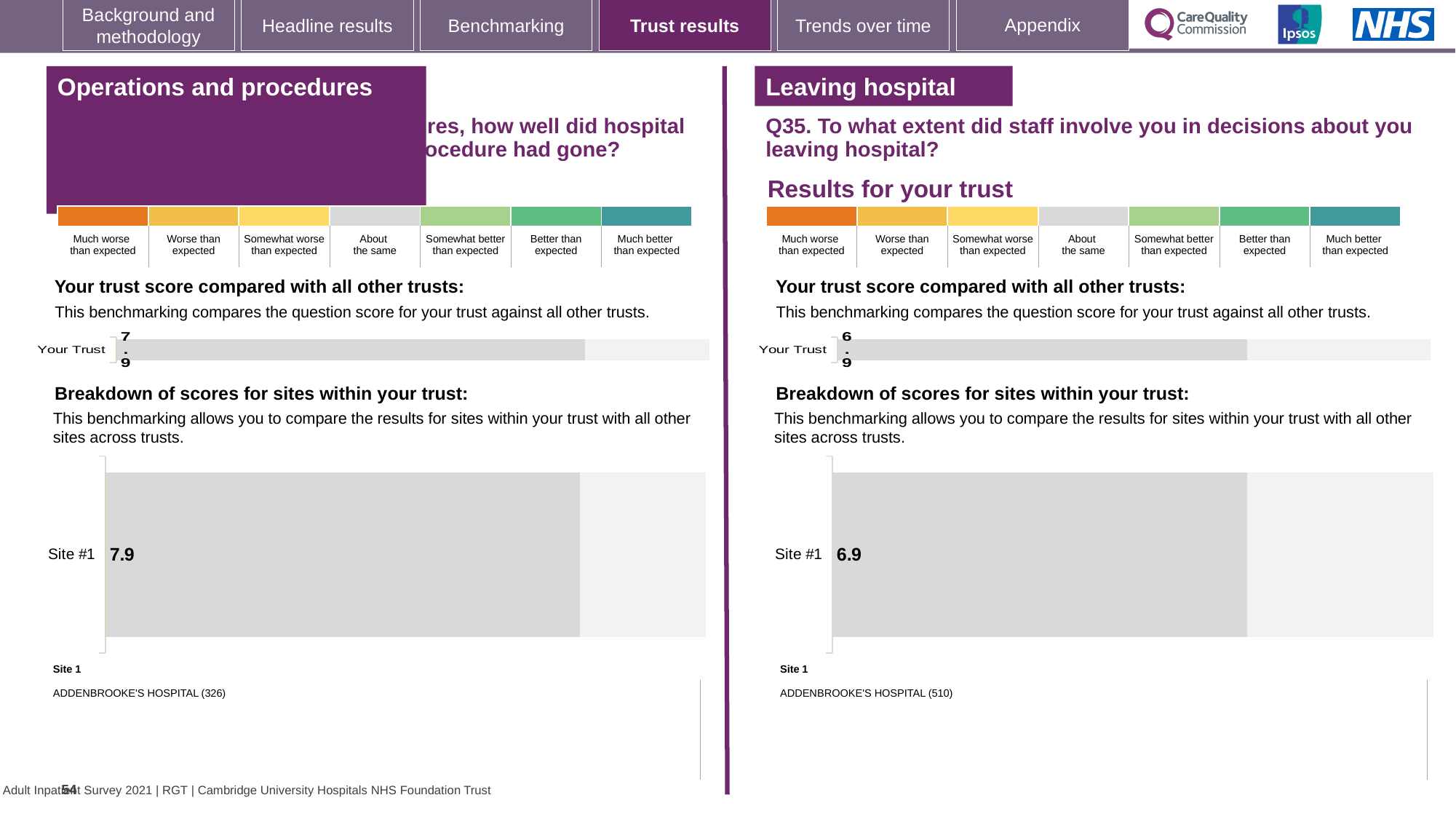
How many sites are shown in the Leaving hospital 'Breakdown of scores for sites within your trust' chart? 1 In the Operations and procedures section, what is the 'Your Trust' score shown on the trust comparison bar chart? 7.9 Is the Site #1 score in the Leaving hospital breakdown chart greater or less than 7? less In the Operations and procedures section, what number appears in parentheses after ADDENBROOKE'S HOSPITAL for Site 1? 326 In the Leaving hospital 'Breakdown of scores for sites within your trust' chart, what is the score for Site #1? 6.9 In the Leaving hospital section, what is the 'Your Trust' score shown on the trust comparison bar chart? 6.9 Which section shows the higher 'Your Trust' score: Operations and procedures or Leaving hospital? Operations and procedures What type of chart is used to show the Site #1 score in the Leaving hospital section? Bar chart What is the difference between the Site #1 score in the Operations and procedures chart and the Site #1 score in the Leaving hospital chart? 1.0 In the Leaving hospital section, which hospital is listed as Site 1 below the site breakdown chart? ADDENBROOKE'S HOSPITAL (510) In the Operations and procedures 'Breakdown of scores for sites within your trust' chart, what is the score for Site #1? 7.9 How many sites are shown in the Operations and procedures 'Breakdown of scores for sites within your trust' chart? 1